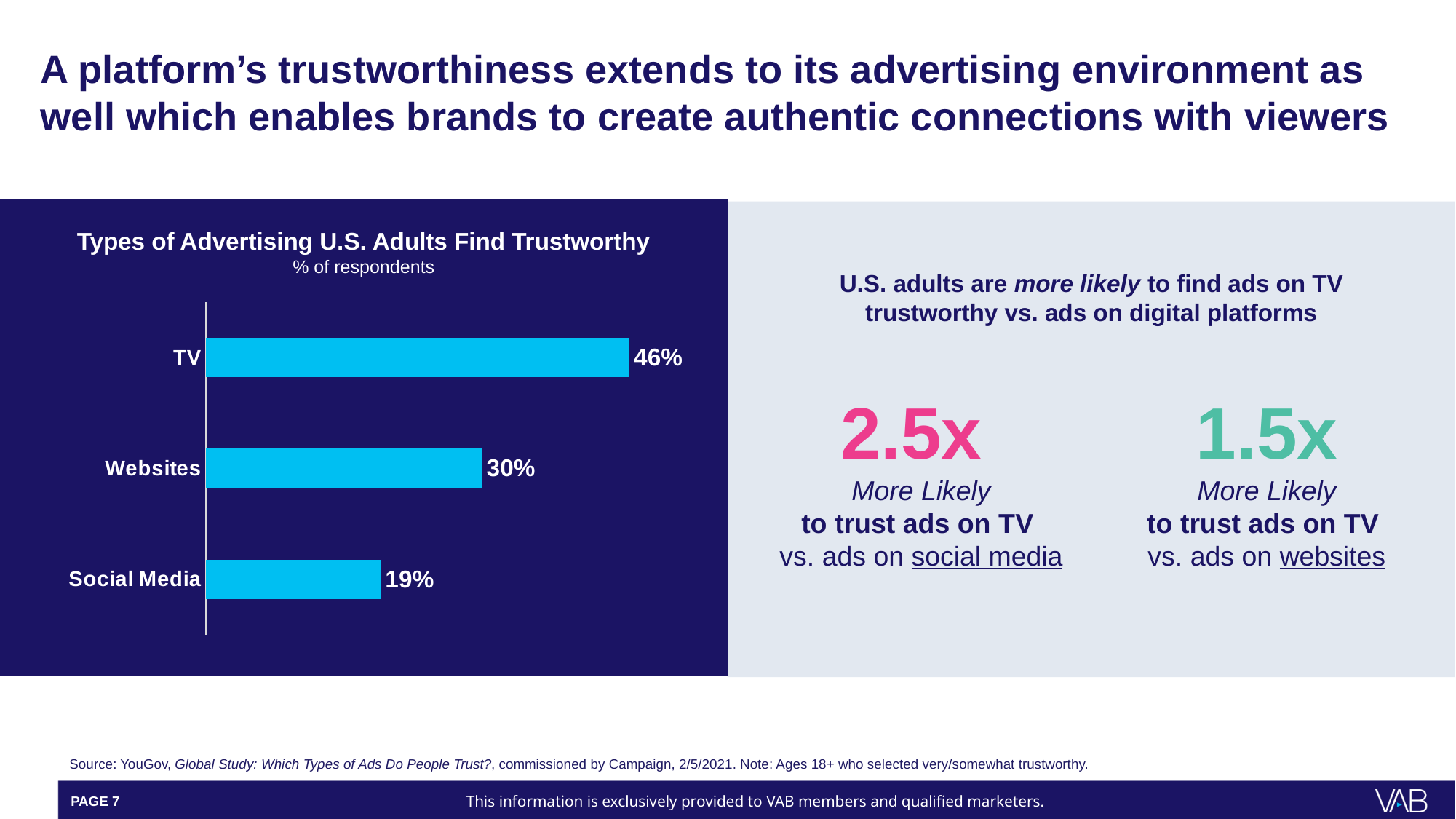
Which type of advertising has the lowest share of respondents finding it trustworthy? Social Media What is the title of the chart? Types of Advertising U.S. Adults Find Trustworthy What is the difference in percentage points between TV and Social Media? 27 percentage points What is the value for Websites in the chart? 30% Which type of advertising has the highest share of respondents finding it trustworthy? TV Which has a higher value, Websites or Social Media? Websites What is the difference in percentage points between TV and Websites? 16 percentage points What percentage of respondents find TV advertising trustworthy? 46% How many types of advertising are shown in the chart? 3 What kind of chart is used to show the types of advertising U.S. adults find trustworthy? Bar chart What is the value for Social Media in the chart? 19% What unit is the chart measured in, according to its subtitle? % of respondents